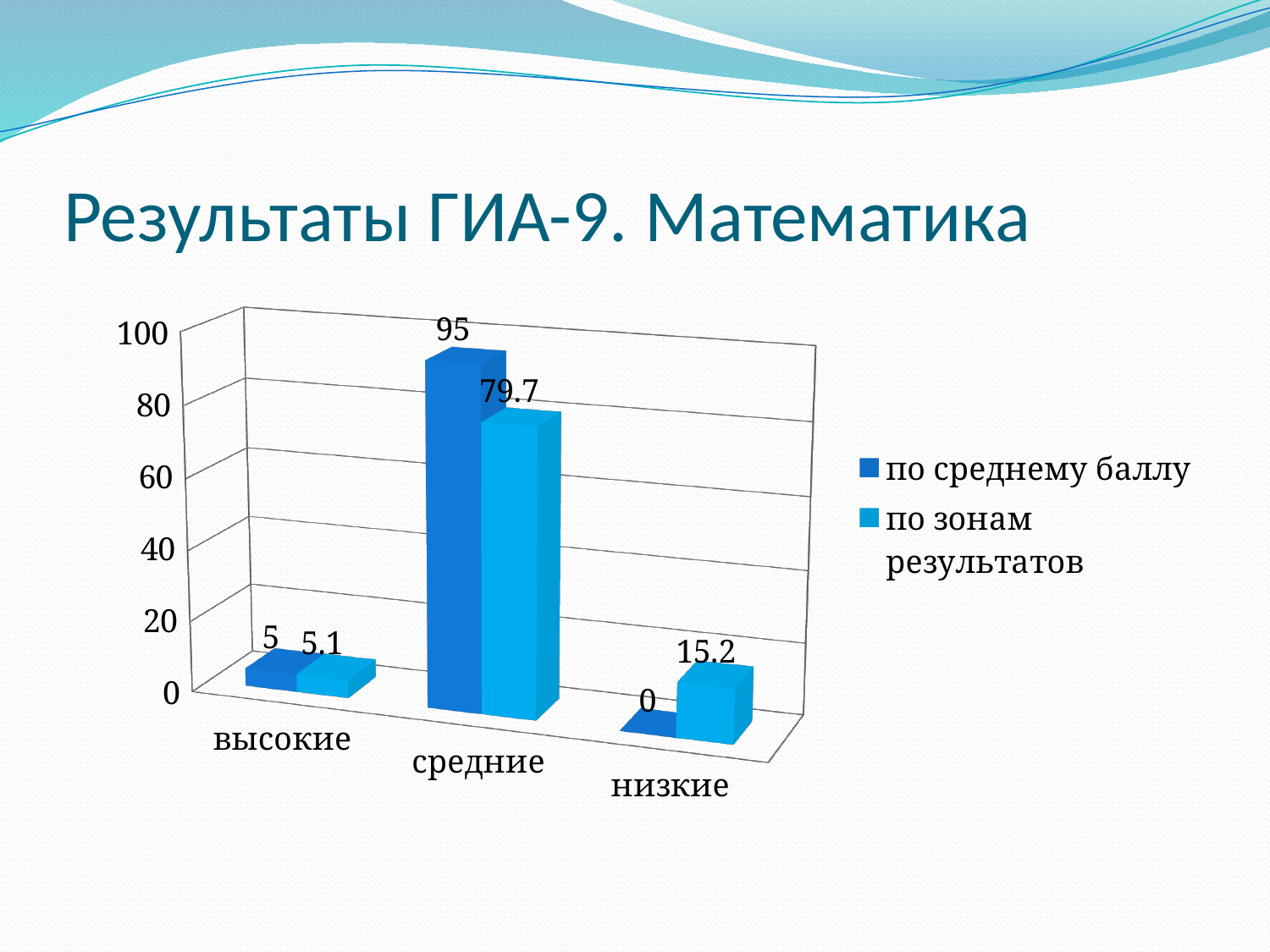
How many categories are shown on the x axis? 3 What is the difference between the "по среднему баллу" and "по зонам результатов" values for "средние"? 15.3 What is the value for "средние" in the "по зонам результатов" series? 79.7 What is the value for "средние" in the "по среднему баллу" series? 95 Which category has the highest value in the "по среднему баллу" series? средние Which category has the lowest value in the "по зонам результатов" series? высокие What type of chart is shown on the slide? bar chart What is the value for "высокие" in the "по зонам результатов" series? 5.1 For "низкие", which series has the larger value: "по среднему баллу" or "по зонам результатов"? по зонам результатов What is the value for "низкие" in the "по зонам результатов" series? 15.2 How many series does the legend list? 2 What is the value for "низкие" in the "по среднему баллу" series? 0